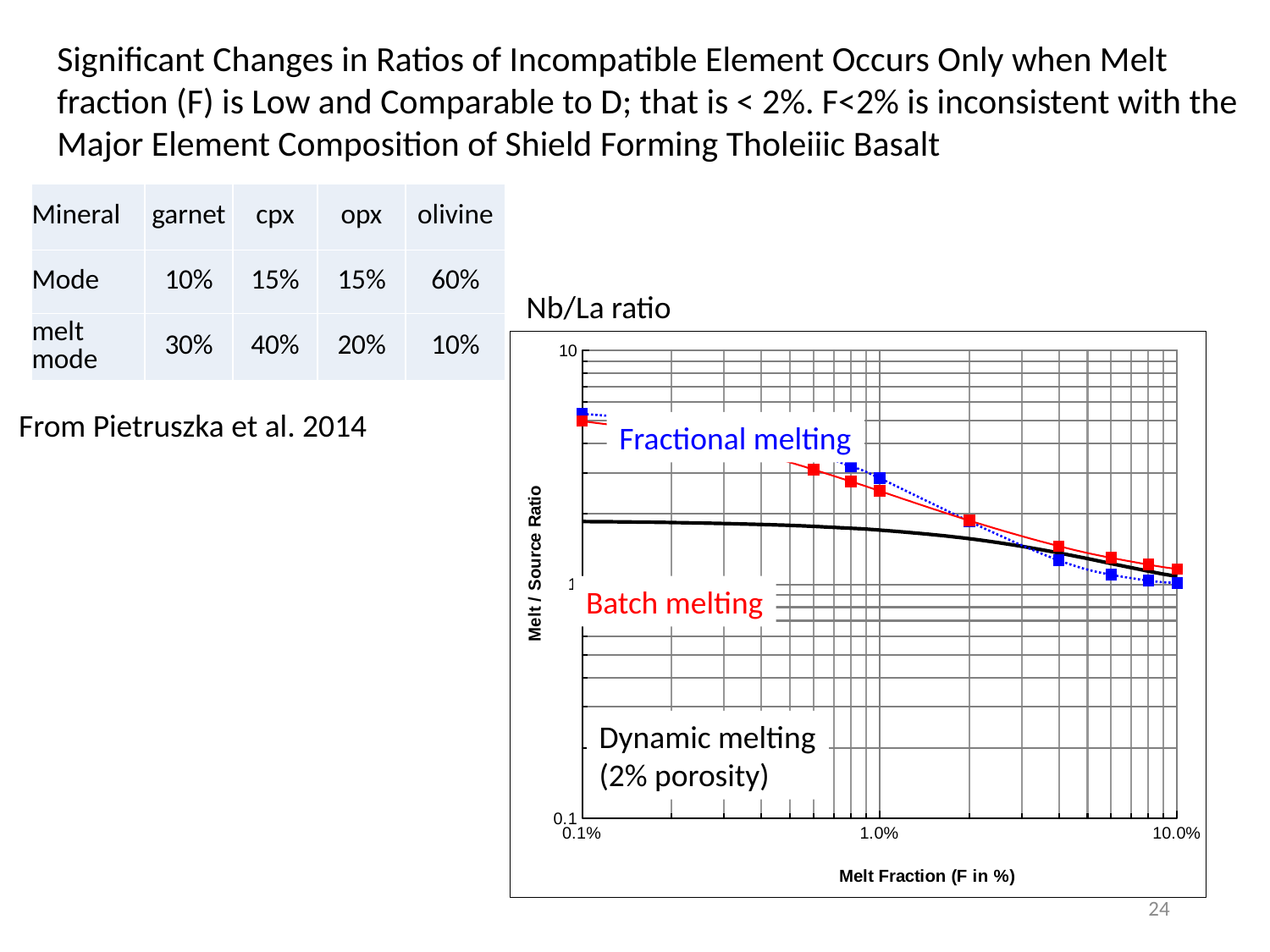
What is the label of the x axis of the chart? Melt Fraction (F in %) At a melt fraction of 0.1%, which curve has the higher Melt / Source Ratio, Fractional melting or Dynamic melting (2% porosity)? Fractional melting Which curve has the highest Melt / Source Ratio at a melt fraction of 0.1%? Fractional melting Is the Batch melting value at a melt fraction of 10.0% greater or less than 10? less Which curve has the lowest Melt / Source Ratio at a melt fraction of 0.1%? Dynamic melting (2% porosity) Is the Fractional melting value at a melt fraction of 0.1% greater or less than 1? greater What kind of chart is shown on the slide? line chart How many melting curves are plotted on the chart? 3 Is the Fractional melting value at a melt fraction of 0.1% greater or less than 10? less Do the Melt / Source Ratio values rise or fall as the melt fraction increases along the x axis? fall What is the title of the chart? Nb/La ratio